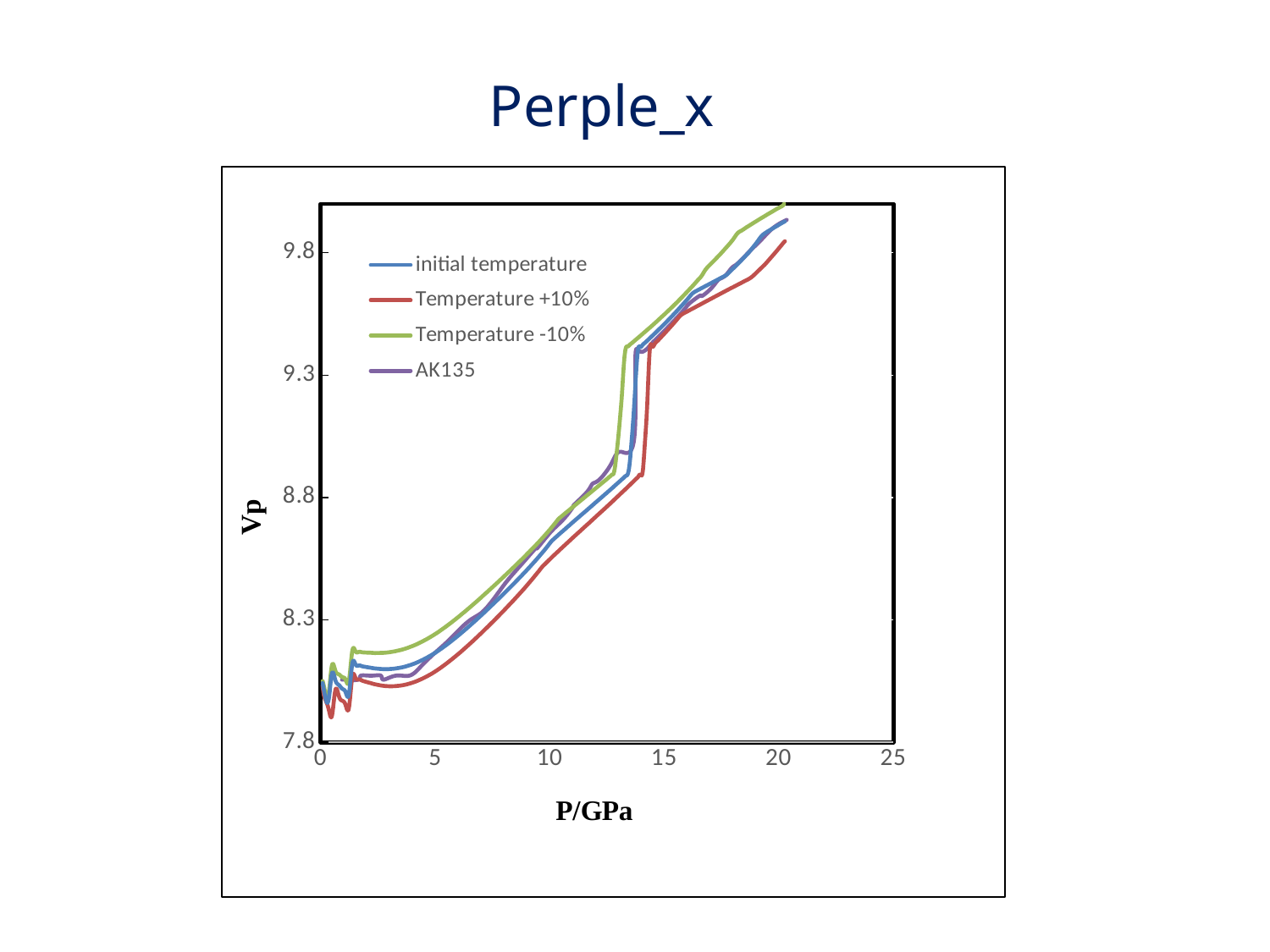
What kind of chart is shown on the slide? line chart At 20 GPa, which series has the lowest Vp? Temperature +10% At 20 GPa, which series has the highest Vp? Temperature -10% Is the Vp value for initial temperature at 10 GPa greater or less than 8.3? greater What is the label of the x axis? P/GPa Is the Vp value for Temperature -10% at 20 GPa greater or less than 9.8? greater At 3 GPa, which has the higher Vp: Temperature -10% or Temperature +10%? Temperature -10% What is the title of the slide above the chart? Perple_x Does Vp generally rise or fall as P/GPa increases? rise Which series is drawn in red? Temperature +10% How many series does the legend list? 4 Is the Vp value for Temperature +10% at 5 GPa greater or less than 8.3? less